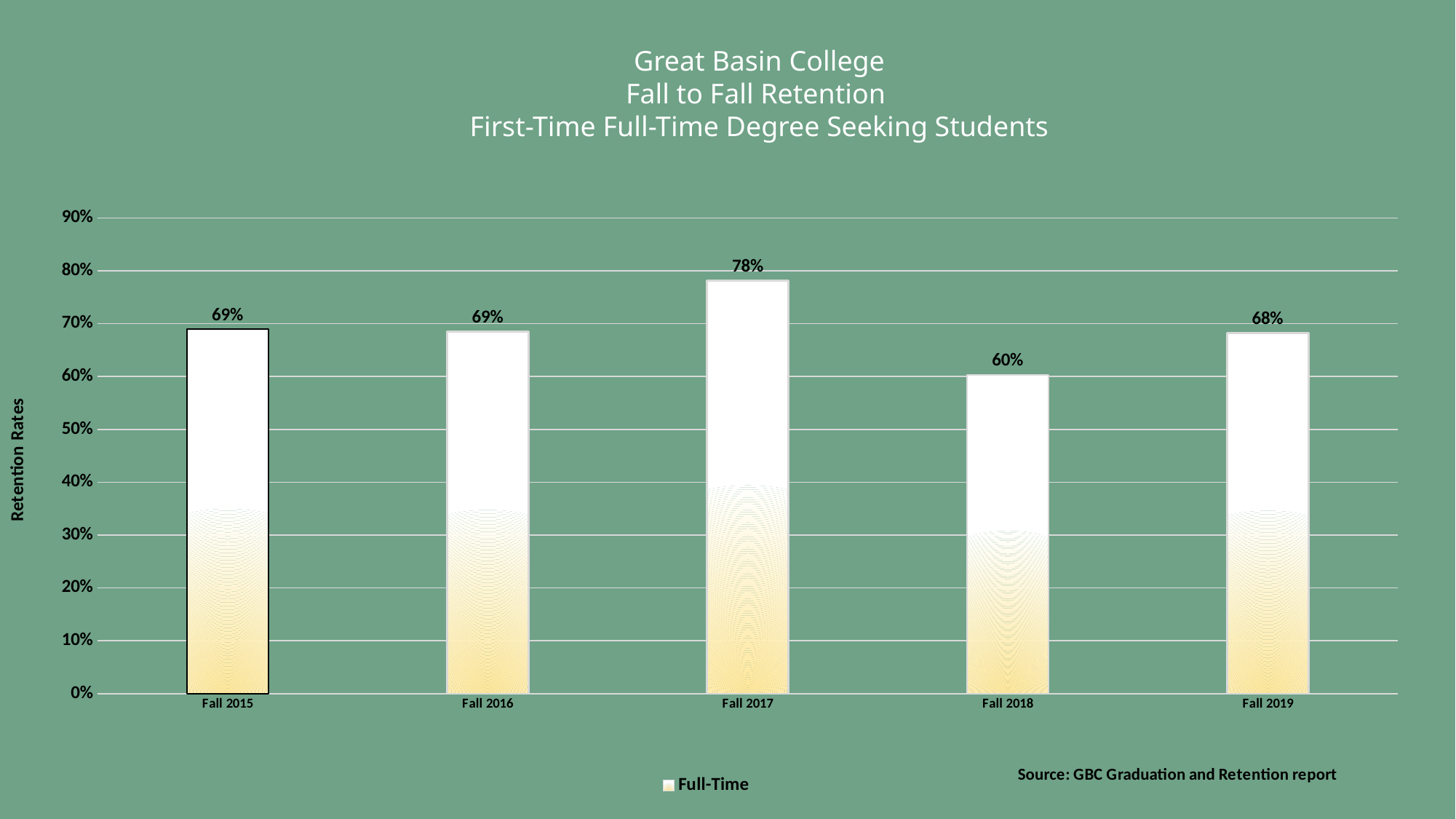
What is the retention rate for Fall 2017? 78% What is the retention rate for Fall 2018? 60% Which fall term has the lowest retention rate? Fall 2018 Is the retention rate for Fall 2018 greater or less than 70%? less What is the retention rate for Fall 2019? 68% How many series does the legend list? 1 Which fall term has the highest retention rate? Fall 2017 What kind of chart is shown on the slide? bar chart What is the difference between the retention rates for Fall 2017 and Fall 2018? 18% What is the label on the vertical axis? Retention Rates Which is larger, the retention rate for Fall 2016 or for Fall 2019? Fall 2016 How many fall terms are shown on the x axis? 5